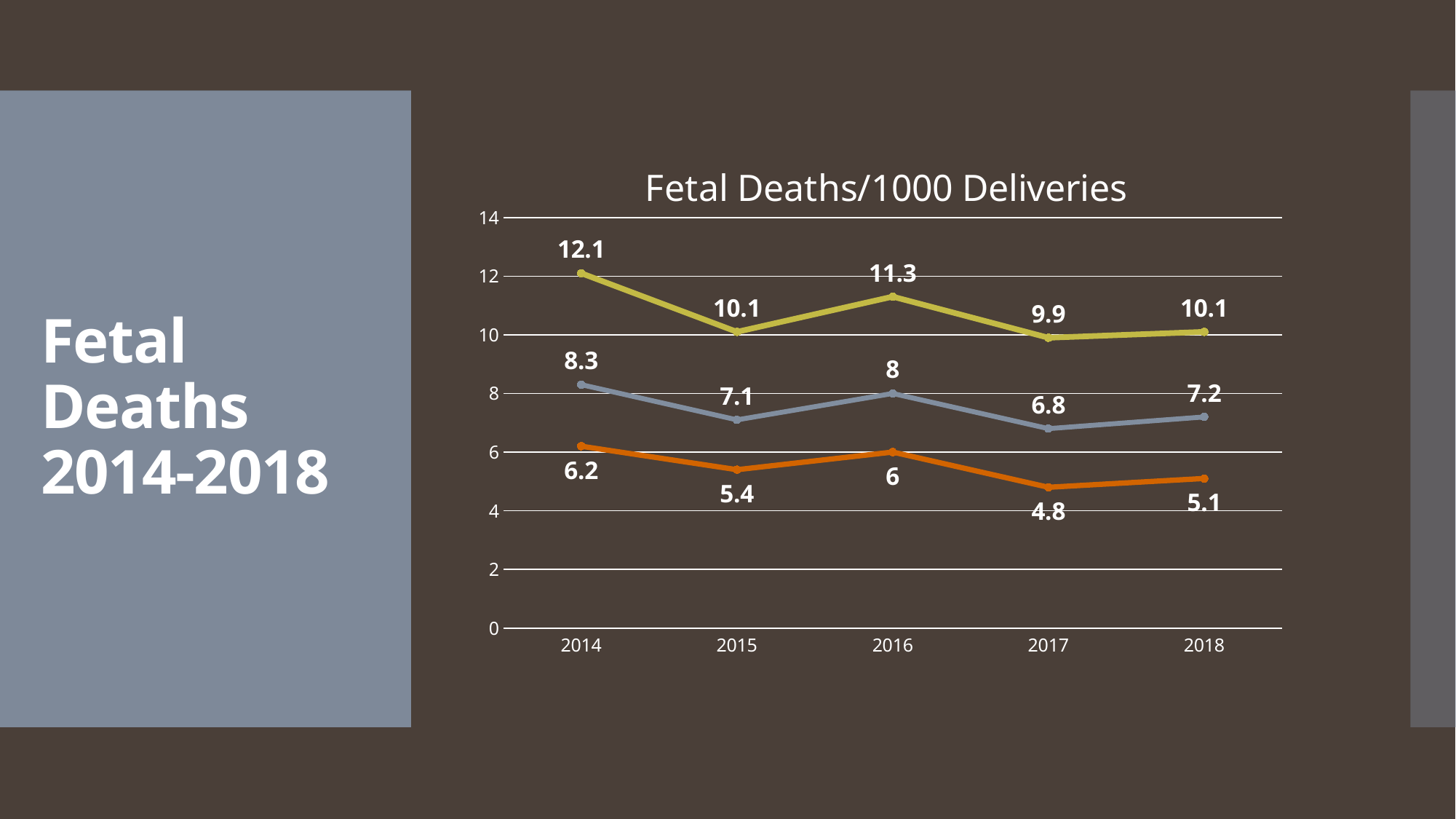
In which year does the yellow line reach its highest value? 2014 How many lines are plotted on the chart? 3 Does the orange line rise or fall from 2014 to 2015? fall What kind of chart is shown on the slide? line chart How many years are shown on the x axis of the chart? 5 For the grey line, which year has the larger value, 2015 or 2018? 2018 In which year does the orange line reach its lowest value? 2017 What is the difference between the yellow line's value in 2014 and its value in 2018? 2 What is the value of the orange line in 2017? 4.8 What is the value of the yellow line in 2014? 12.1 What is the title of the chart? Fetal Deaths/1000 Deliveries What is the value of the grey line in 2016? 8